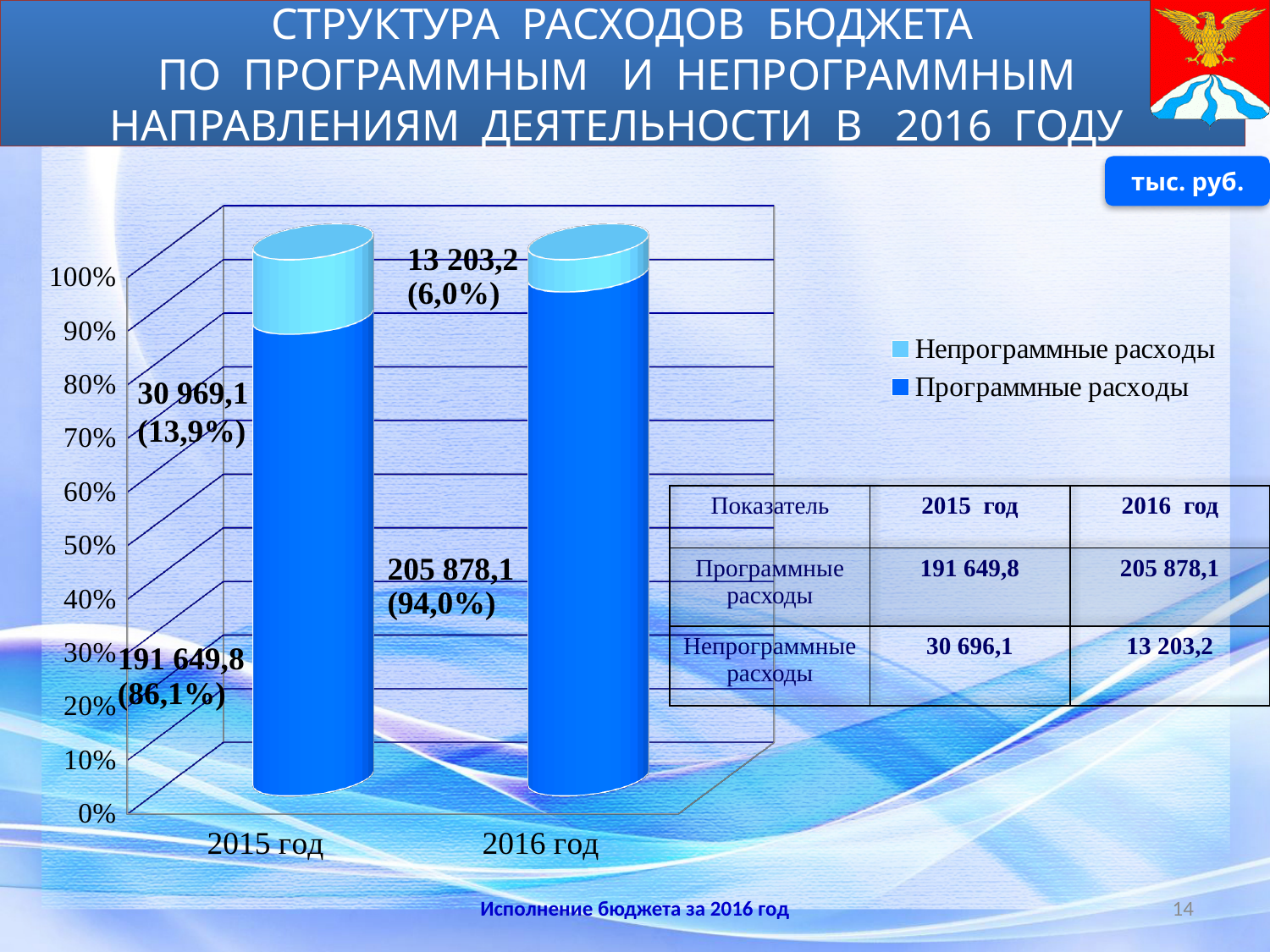
What is the value of Программные расходы for 2016 год in the chart? 205 878,1 Which year has the larger value of Программные расходы, 2015 год or 2016 год? 2016 год What share of the 2016 год bar is Программные расходы? 94,0% What share of the 2015 год bar is Непрограммные расходы? 13,9% How many series does the chart legend list? 2 What is the value of Программные расходы for 2015 год in the chart? 191 649,8 What is the value of Непрограммные расходы for 2016 год in the chart? 13 203,2 Does the share of Непрограммные расходы rise or fall from 2015 год to 2016 год? fall What kind of chart is shown on the slide? bar chart By how much did Программные расходы increase from 2015 год to 2016 год? 14 228,3 Which series is shown in the lighter blue colour in the chart legend? Непрограммные расходы How many categories (years) are shown on the x axis of the chart? 2